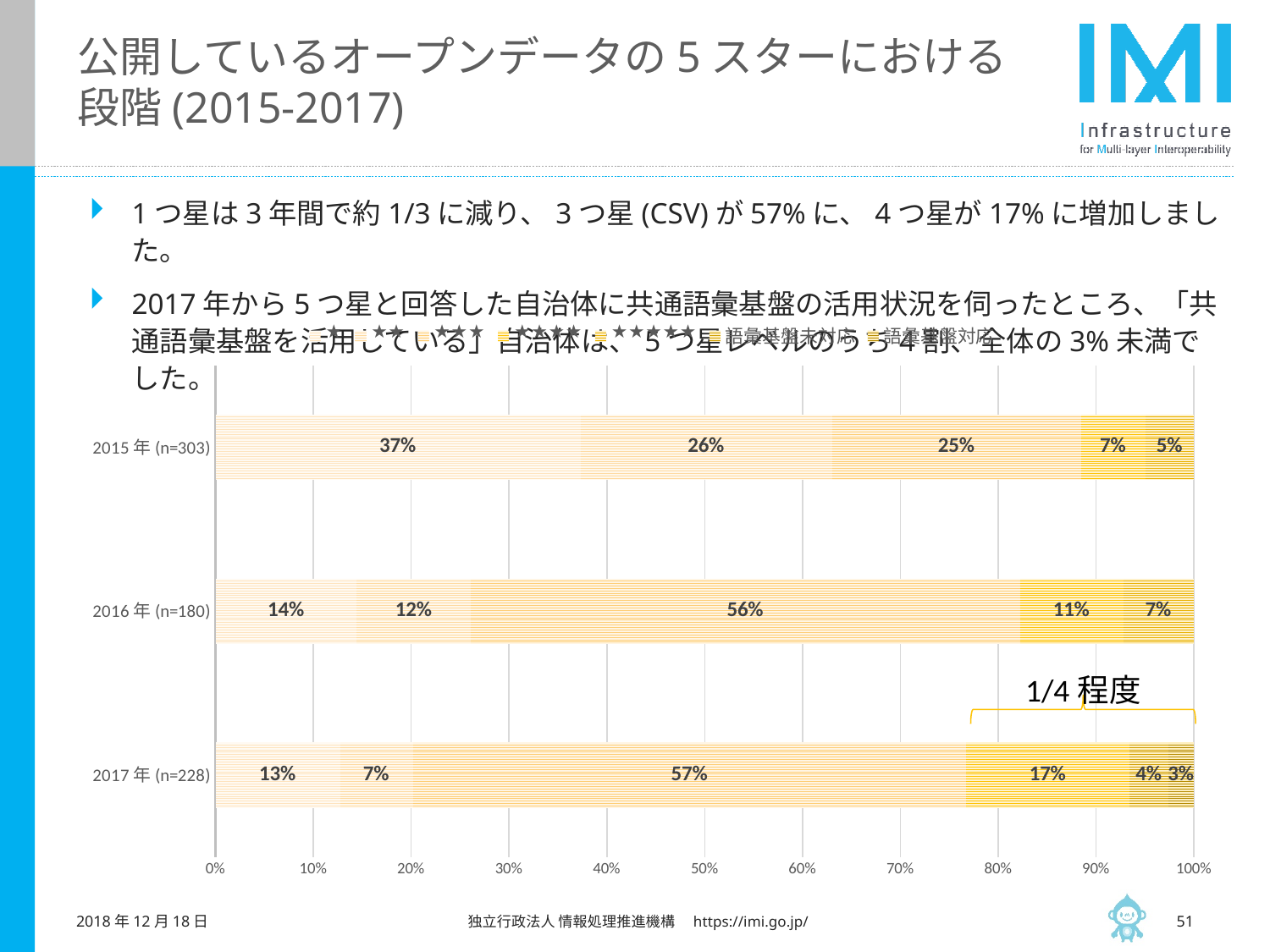
Which year has the larger leftmost segment, 2015年 (n=303) or 2016年 (n=180)? 2015年 (n=303) What is the value of the rightmost segment of the 2016年 (n=180) bar? 7% What is the value of the fourth segment from the left in the 2017年 (n=228) bar? 17% What kind of chart is shown on the slide? Stacked bar chart What is the value of the leftmost segment of the 2015年 (n=303) bar? 37% What is the value of the largest segment in the 2016年 (n=180) bar? 56% What annotation text is written above the right end of the 2017年 (n=228) bar? 1/4 程度 What is the total of all segments in the 2015年 (n=303) bar? 100% How many year categories (bars) does the chart show? 3 What is the value of the leftmost segment of the 2017年 (n=228) bar? 13% What is the difference between the leftmost segment of the 2015年 (n=303) bar (37%) and the leftmost segment of the 2017年 (n=228) bar (13%)? 24 percentage points Which year's bar has the largest leftmost segment? 2015年 (n=303)